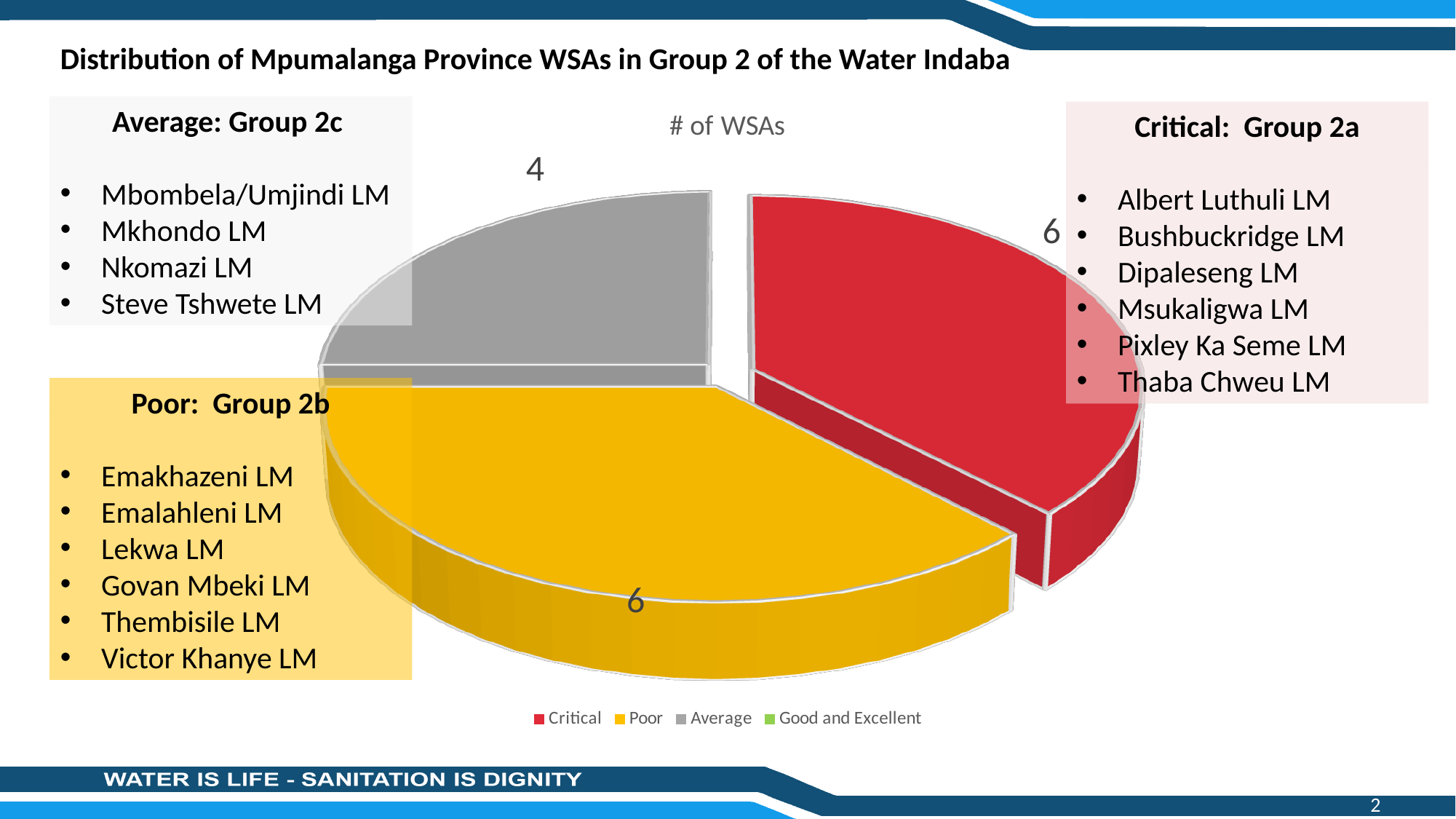
What colour is the Poor slice in the pie chart? Yellow What is the title of the chart? # of WSAs Which is larger, the Poor slice or the Average slice? Poor Which is larger, the Critical slice or the Average slice? Critical What is the value for the Critical slice? 6 What type of chart is shown on the slide? Pie chart What is the value for the Average slice? 4 How many slices with data labels are plotted in the pie chart? 3 How many entries does the chart legend list? 4 Which legend entry has no visible slice in the pie chart? Good and Excellent What is the difference between the Critical value and the Average value? 2 What is the value for the Poor slice? 6